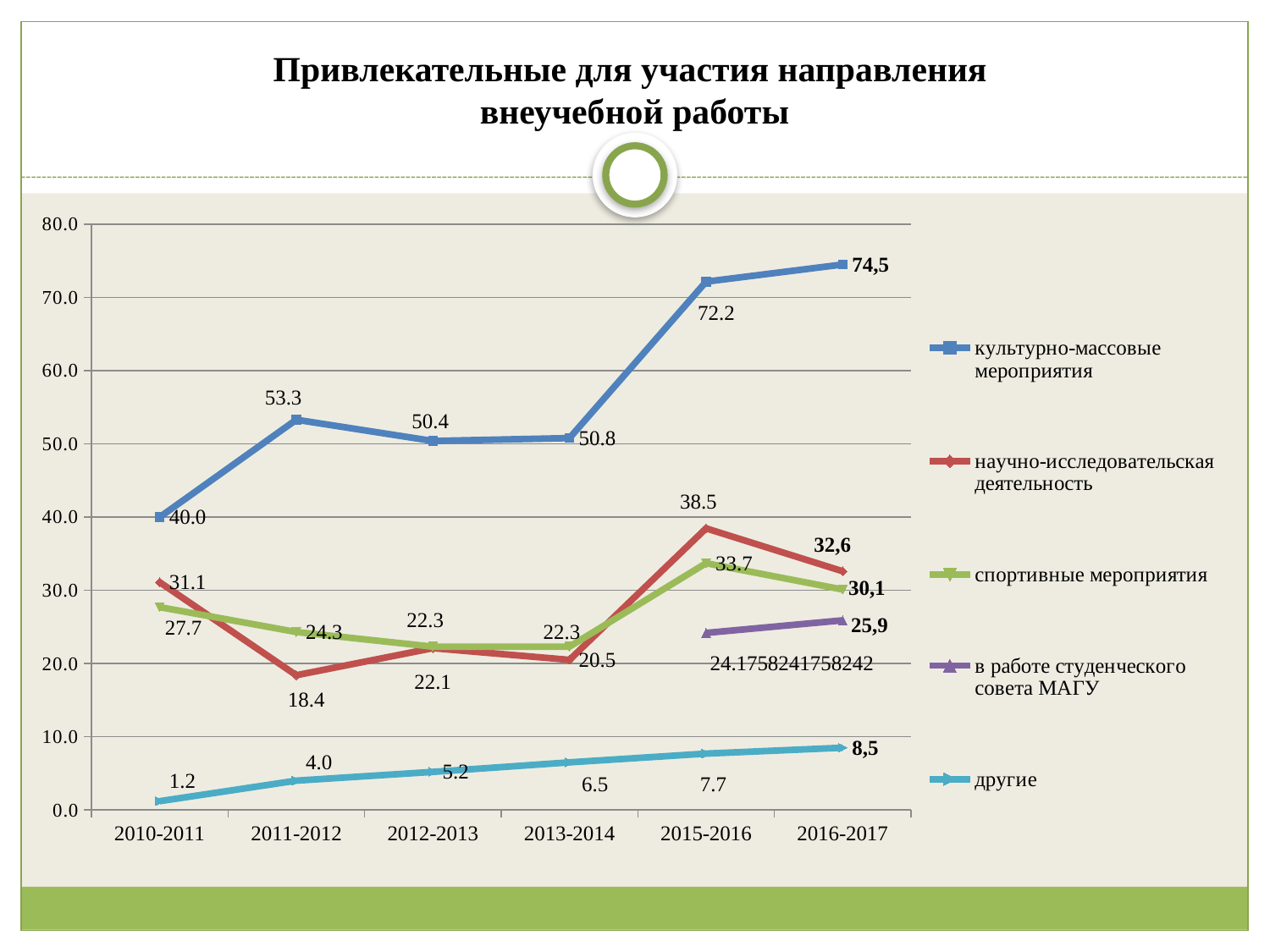
Does the value for другие rise or fall from 2010-2011 to 2016-2017? rise What kind of chart is shown on the slide? line chart What is the value for культурно-массовые мероприятия in 2016-2017? 74,5 What is the value for научно-исследовательская деятельность in 2011-2012? 18.4 What is the value for другие in 2010-2011? 1.2 Which is larger in 2016-2017: научно-исследовательская деятельность or спортивные мероприятия? научно-исследовательская деятельность In which year does научно-исследовательская деятельность have its lowest value? 2011-2012 How many academic-year categories are shown on the x axis? 6 How many series does the legend list? 5 What is the value for спортивные мероприятия in 2015-2016? 33.7 In which year does культурно-массовые мероприятия reach its highest value? 2016-2017 What is the difference between the культурно-массовые мероприятия values in 2015-2016 and 2013-2014? 21.4